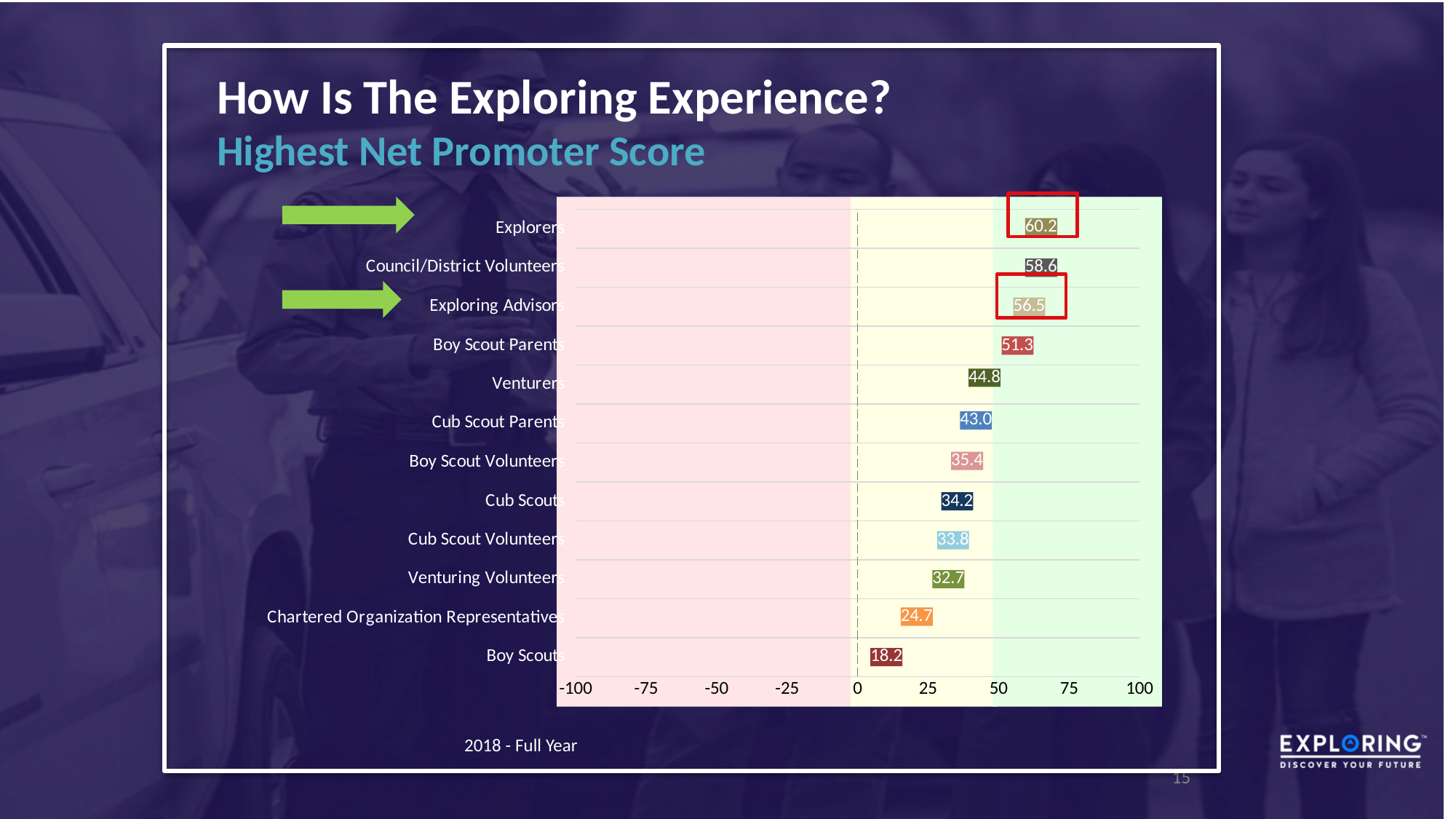
What is the value shown for Chartered Organization Representatives? 24.7 Is the value for Boy Scout Parents greater or less than 50? greater What is the difference between the scores for Council/District Volunteers and Boy Scouts? 40.4 Which category has the lowest Net Promoter Score? Boy Scouts What is the difference between the scores for Explorers and Exploring Advisors? 3.7 What kind of chart is shown on the slide? Bar chart What is the value shown for Boy Scouts? 18.2 How many categories are shown in the chart? 12 Which has a higher score, Cub Scout Parents or Venturers? Venturers What is the Net Promoter Score for Exploring Advisors? 56.5 Which category has the highest Net Promoter Score? Explorers What is the Net Promoter Score for Explorers? 60.2